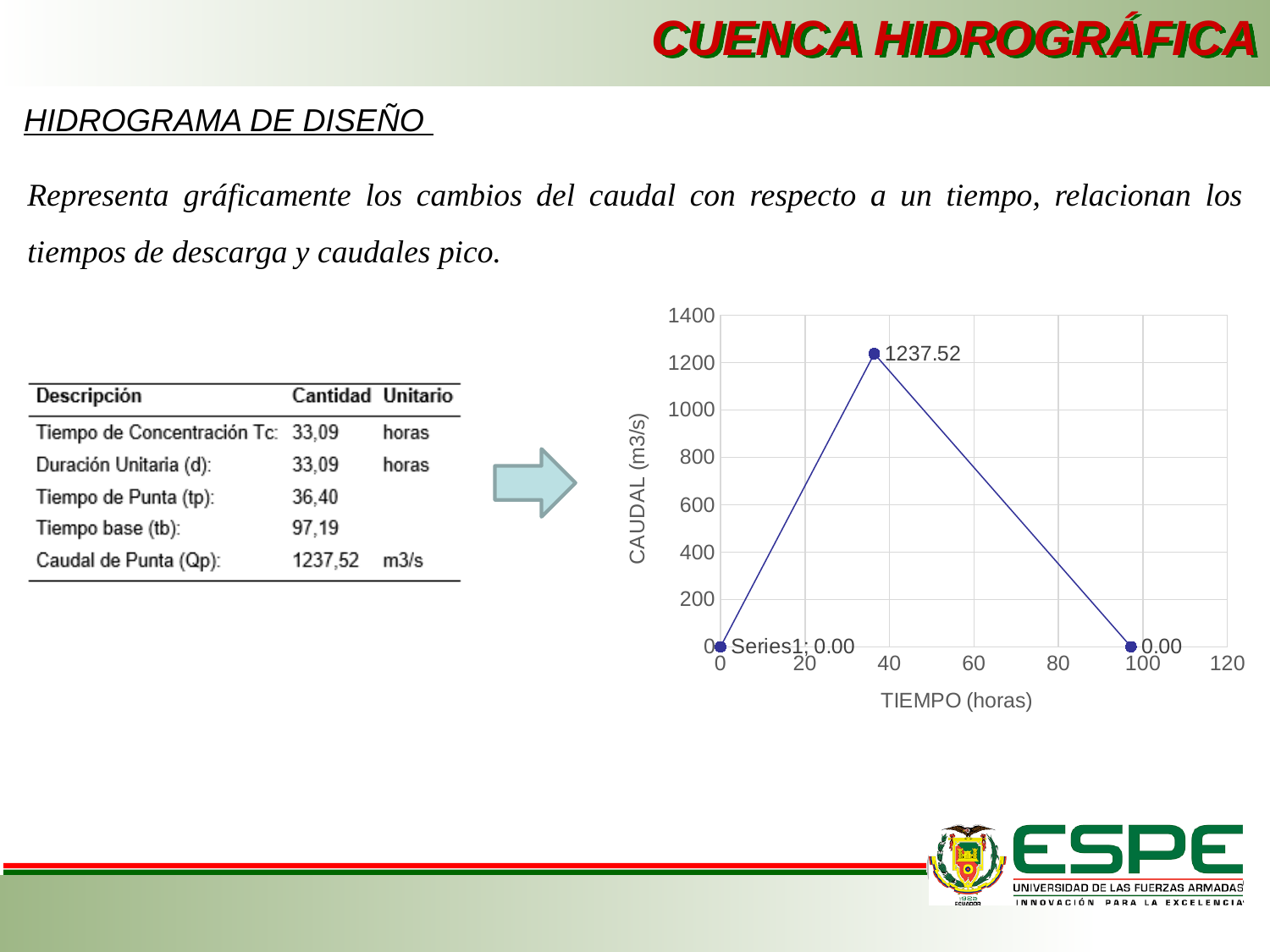
What kind of chart is shown on the slide? line chart What is the title of the vertical axis of the chart? CAUDAL (m3/s) How does the CAUDAL value change along the TIEMPO axis? rises to a peak, then falls back to 0 Is the TIEMPO (horas) value of the last point greater or less than 80? greater How many data points are plotted on the chart? 3 Is the TIEMPO (horas) value at which the peak occurs greater or less than 20? greater What is the title of the horizontal axis of the chart? TIEMPO (horas) What is the peak value of CAUDAL (m3/s) shown as a data label on the chart? 1237.52 What is the data label value of the first point on the chart, at TIEMPO 0? 0.00 What is the difference between the peak value and the value of the first point on the chart? 1237.52 What is the data label value of the last point on the chart, near TIEMPO 100? 0.00 Is the TIEMPO (horas) value at which the peak occurs greater or less than 40? less